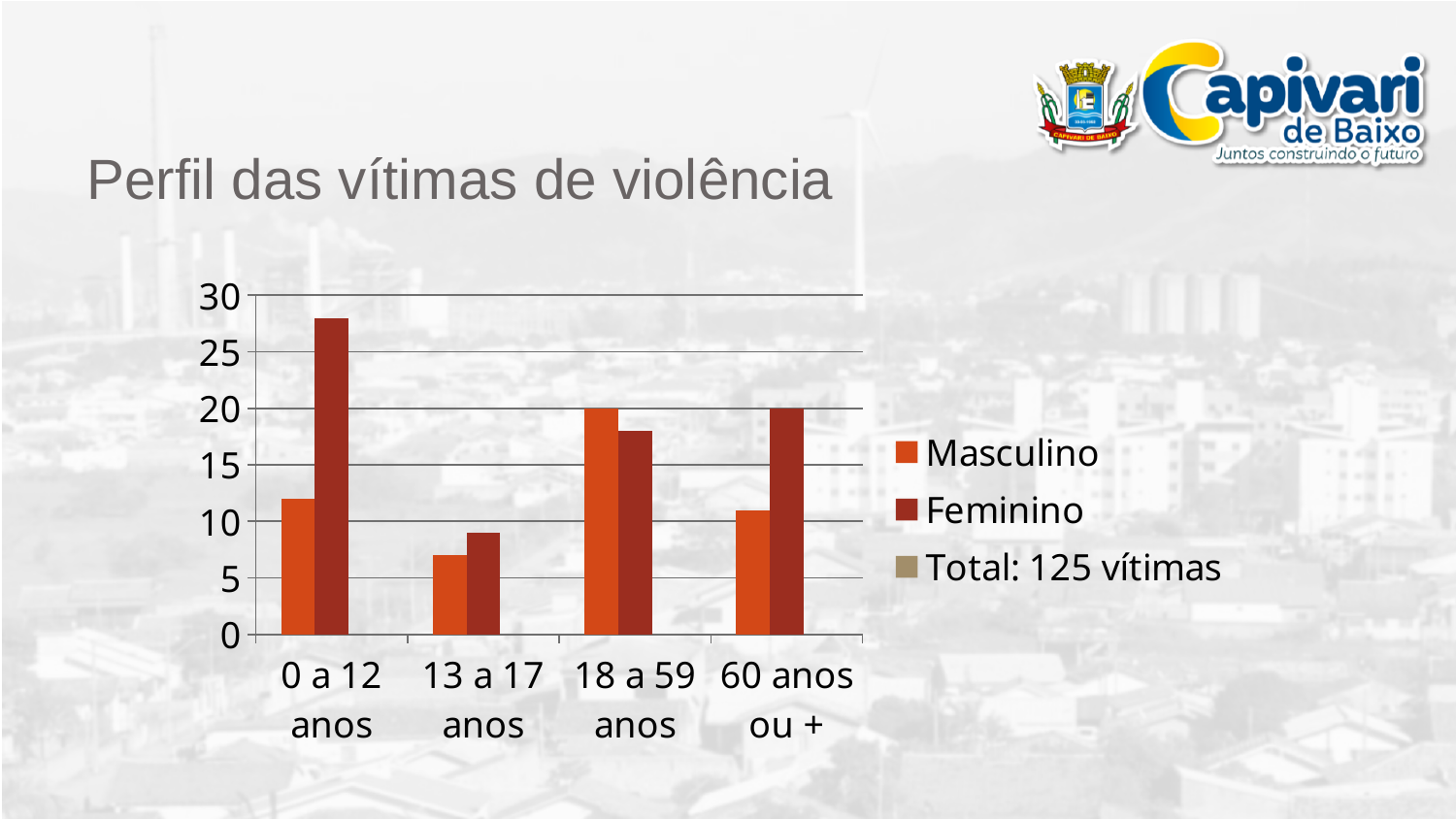
Which age category has the lowest Masculino bar? 13 a 17 anos What is the Feminino value for the 60 anos ou + category? 20 Is the Masculino value for 13 a 17 anos greater or less than 10? less What is the Masculino value for the 18 a 59 anos category? 20 How many series does the legend list? 3 What kind of chart is shown on the slide? bar chart Which age category has the highest Feminino bar? 0 a 12 anos How many age categories are shown on the x axis? 4 Is the Feminino value for 0 a 12 anos greater or less than 25? greater In the 0 a 12 anos category, which is larger, the Masculino or the Feminino bar? Feminino In the 60 anos ou + category, which is larger, the Masculino or the Feminino bar? Feminino What is the title of the slide above the chart? Perfil das vítimas de violência